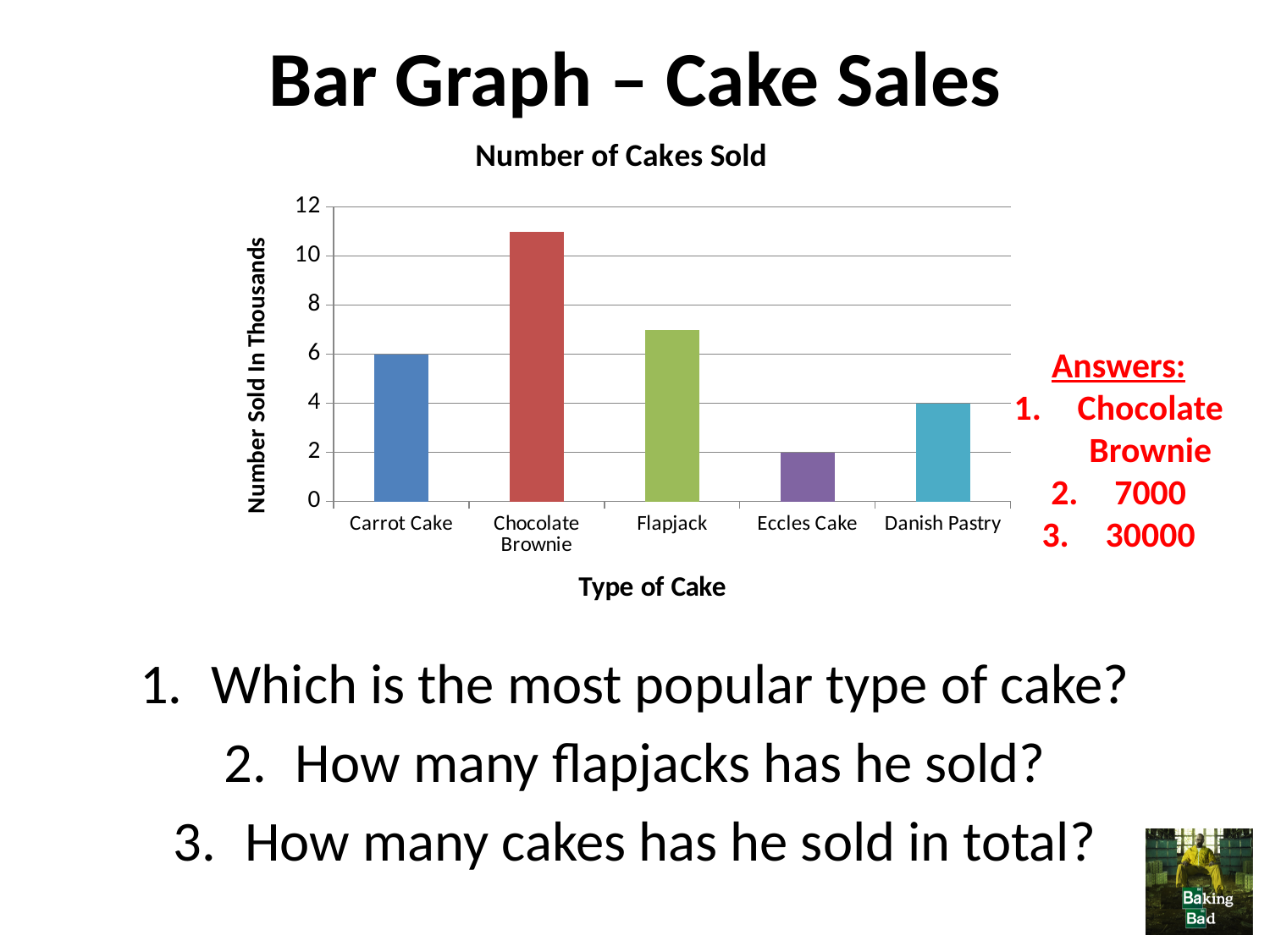
What is the difference (in thousands) between Carrot Cake and Danish Pastry? 2 Is the value for Chocolate Brownie greater or less than 10? greater What is the value (in thousands) for Danish Pastry? 4 Which type of cake has the highest number sold? Chocolate Brownie What type of chart is shown on the slide? bar chart How many types of cake are shown on the chart? 5 What is the value (in thousands) for Eccles Cake? 2 What is the title of the chart? Number of Cakes Sold What is the value (in thousands) for Carrot Cake? 6 Which type of cake has the lowest number sold? Eccles Cake Which has a larger value, Flapjack or Danish Pastry? Flapjack What is the label on the vertical axis of the chart? Number Sold In Thousands